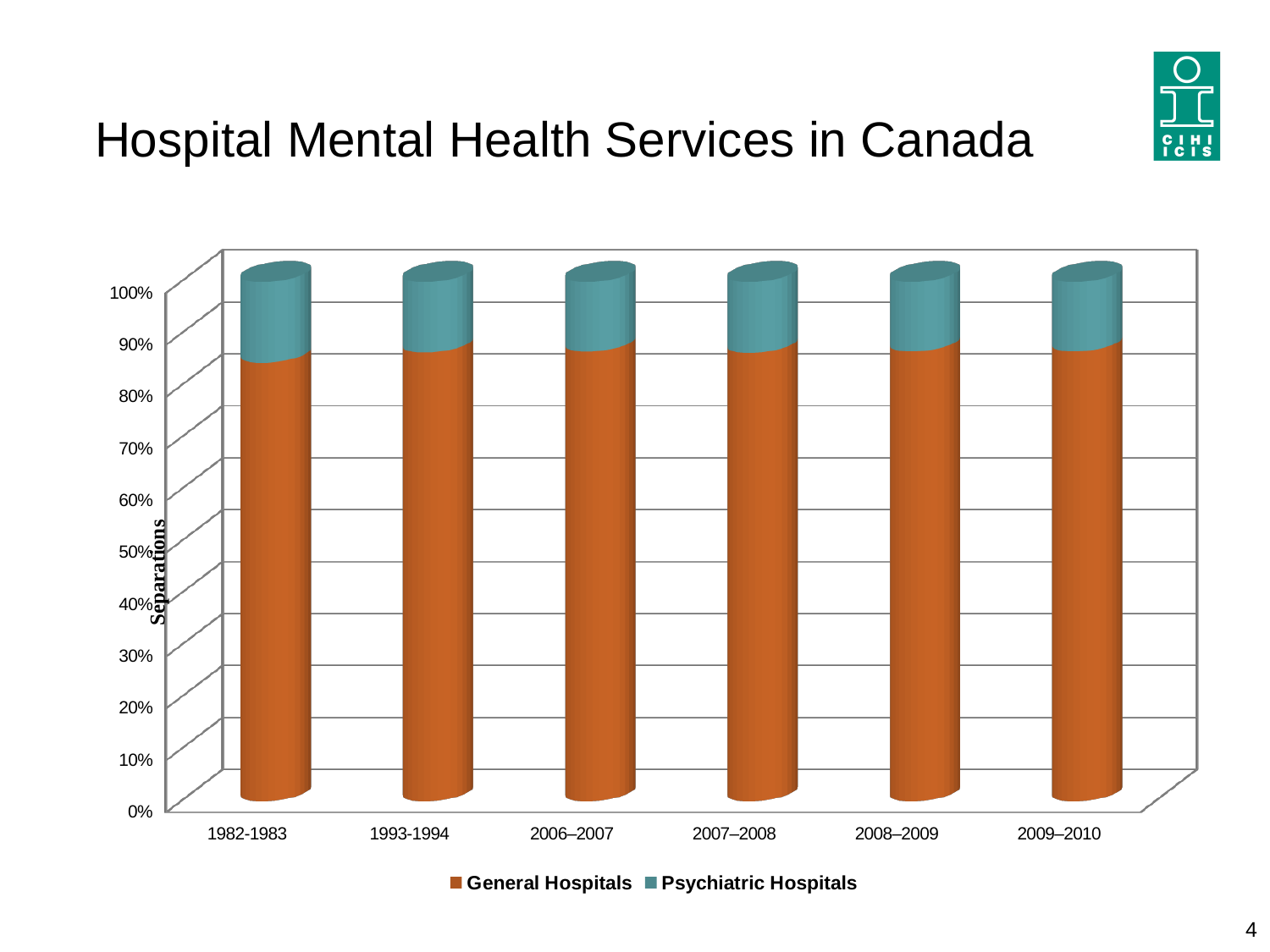
Is the value for General Hospitals in 2009–2010 greater or less than 70%? greater What is the total of the stacked bar for 2006–2007? 100% Is the value for General Hospitals in 1982-1983 greater or less than 90%? less Is the value for General Hospitals in 1982-1983 greater or less than 80%? greater How many series does the chart legend list? 2 What is the label on the vertical axis of the chart? Separations What kind of chart is shown on the slide? Stacked bar chart Which time period has the lowest share for General Hospitals? 1982-1983 How many time periods are shown on the x axis of the chart? 6 Which time period has the highest share for Psychiatric Hospitals? 1982-1983 What are the two series named in the chart legend? General Hospitals and Psychiatric Hospitals